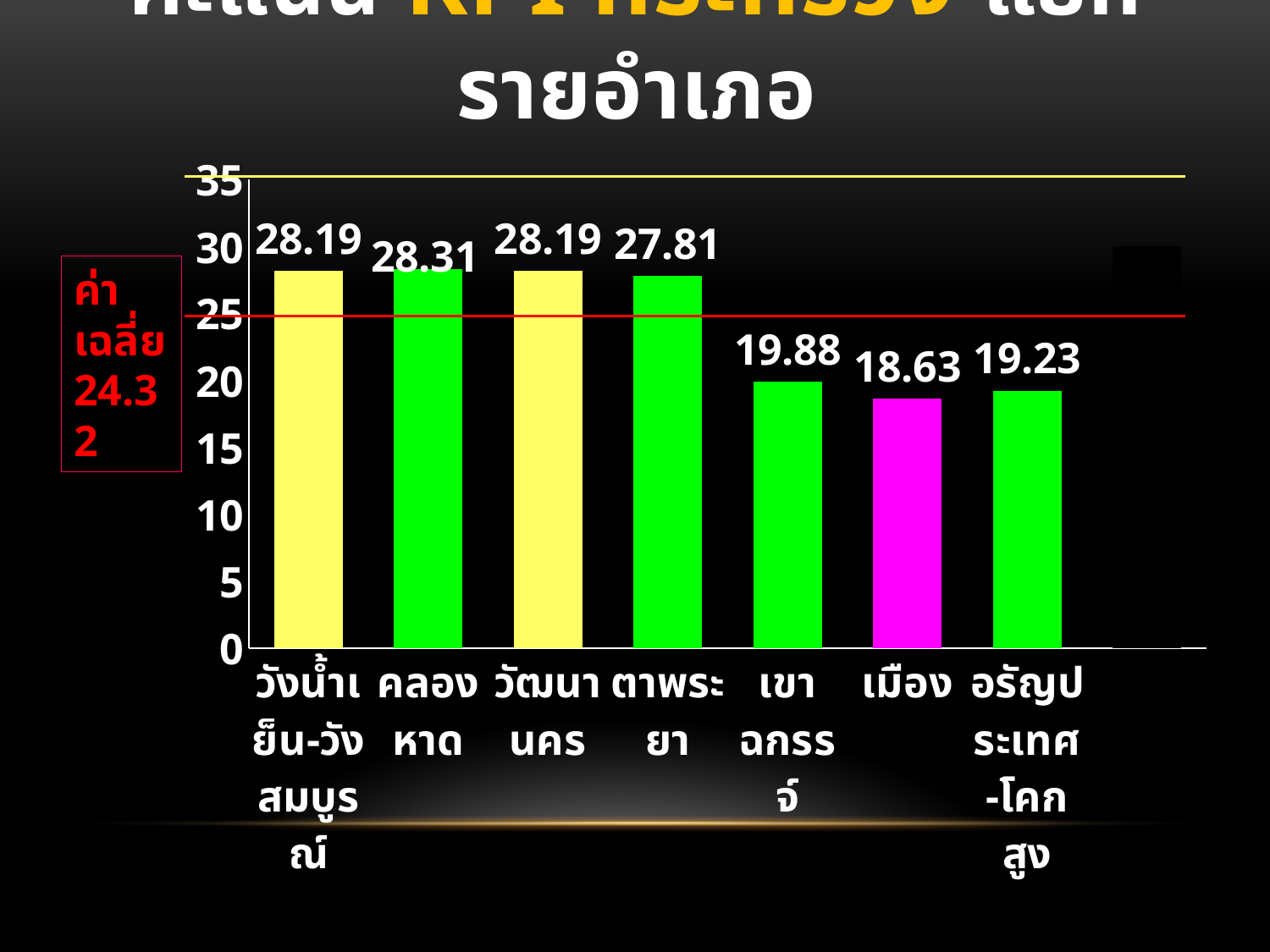
How many categories are shown on the x axis? 7 What is the value for เมือง? 18.63 Which category has the lowest value? เมือง What is the value for เขาฉกรรจ์? 19.88 What is the value for คลองหาด? 28.31 What is the value for ตาพระยา? 27.81 Which is larger, the value for เขาฉกรรจ์ or the value for อรัญประเทศ-โคกสูง? เขาฉกรรจ์ Is the value for ตาพระยา greater or less than 25? greater What kind of chart is shown on the slide? bar chart What is the difference between the values for คลองหาด and เมือง? 9.68 Which category has the highest value? คลองหาด What average value (ค่าเฉลี่ย) is marked by the red line on the chart? 24.32